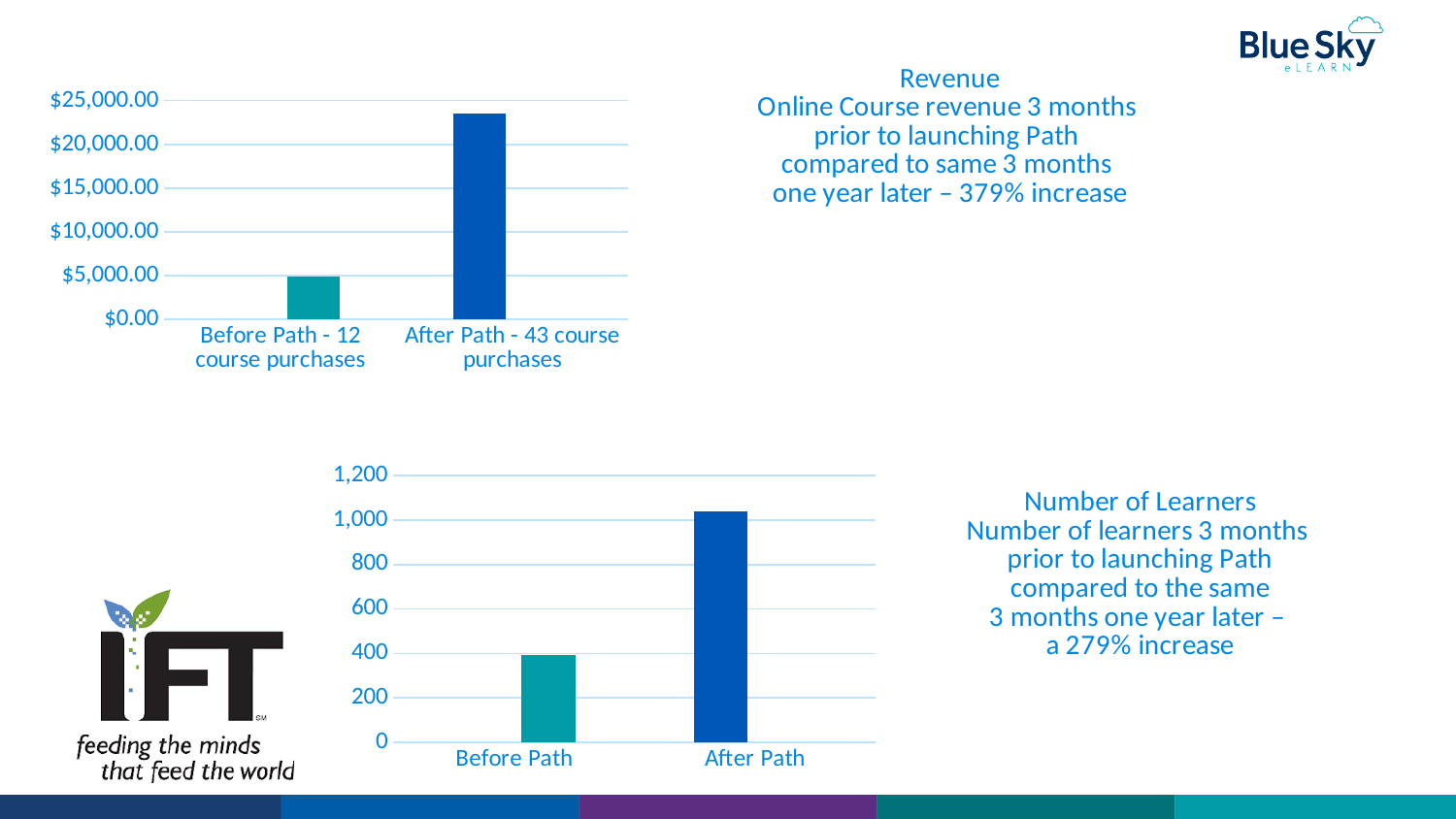
In the Number of Learners chart at the bottom, which category has the higher value? After Path How many categories are shown in the Revenue chart? 2 In the Revenue chart, which category has the higher value? After Path - 43 course purchases In the Number of Learners chart, is the value for After Path greater or less than 800? greater In the Number of Learners chart, is the value for Before Path larger or smaller than the value for After Path? smaller How many categories are shown in the Number of Learners chart? 2 What kind of chart is the Revenue chart at the top of the slide? bar chart According to the text next to the Revenue chart, what percentage increase in revenue is reported? 379% In the Revenue chart, which category has the lower value? Before Path - 12 course purchases In the Number of Learners chart, is the value for Before Path greater or less than 600? less In the Revenue chart, is the value for Before Path greater or less than $10,000.00? less